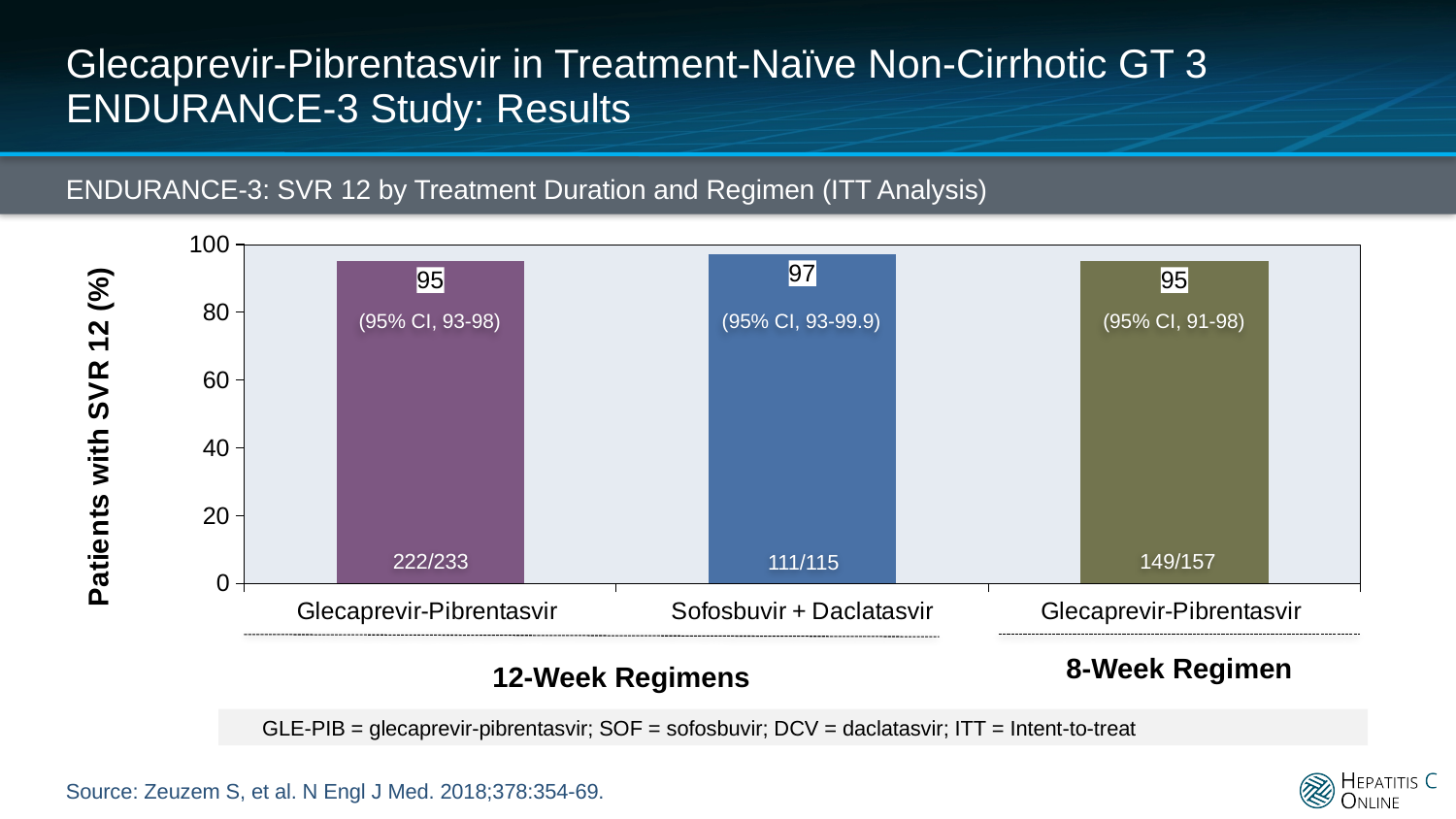
How many patients achieved SVR 12 out of the total in the 12-week Glecaprevir-Pibrentasvir arm? 222/233 Is the SVR 12 rate for the 12-week Sofosbuvir + Daclatasvir regimen greater or less than 80? greater How many bars are shown in the chart? 3 What is the SVR 12 rate for the 8-week Glecaprevir-Pibrentasvir regimen? 95 What is the difference in SVR 12 rate between the 12-week Sofosbuvir + Daclatasvir regimen and the 8-week Glecaprevir-Pibrentasvir regimen? 2 What is the 95% confidence interval shown for the Sofosbuvir + Daclatasvir bar? 93-99.9 How many patients achieved SVR 12 out of the total in the 8-week Glecaprevir-Pibrentasvir arm? 149/157 What is the label of the y-axis? Patients with SVR 12 (%) Which regimen has the highest SVR 12 rate? Sofosbuvir + Daclatasvir What type of chart is shown on the slide? Bar chart What is the SVR 12 rate for the 12-week Sofosbuvir + Daclatasvir regimen? 97 What is the SVR 12 rate for the 12-week Glecaprevir-Pibrentasvir regimen? 95